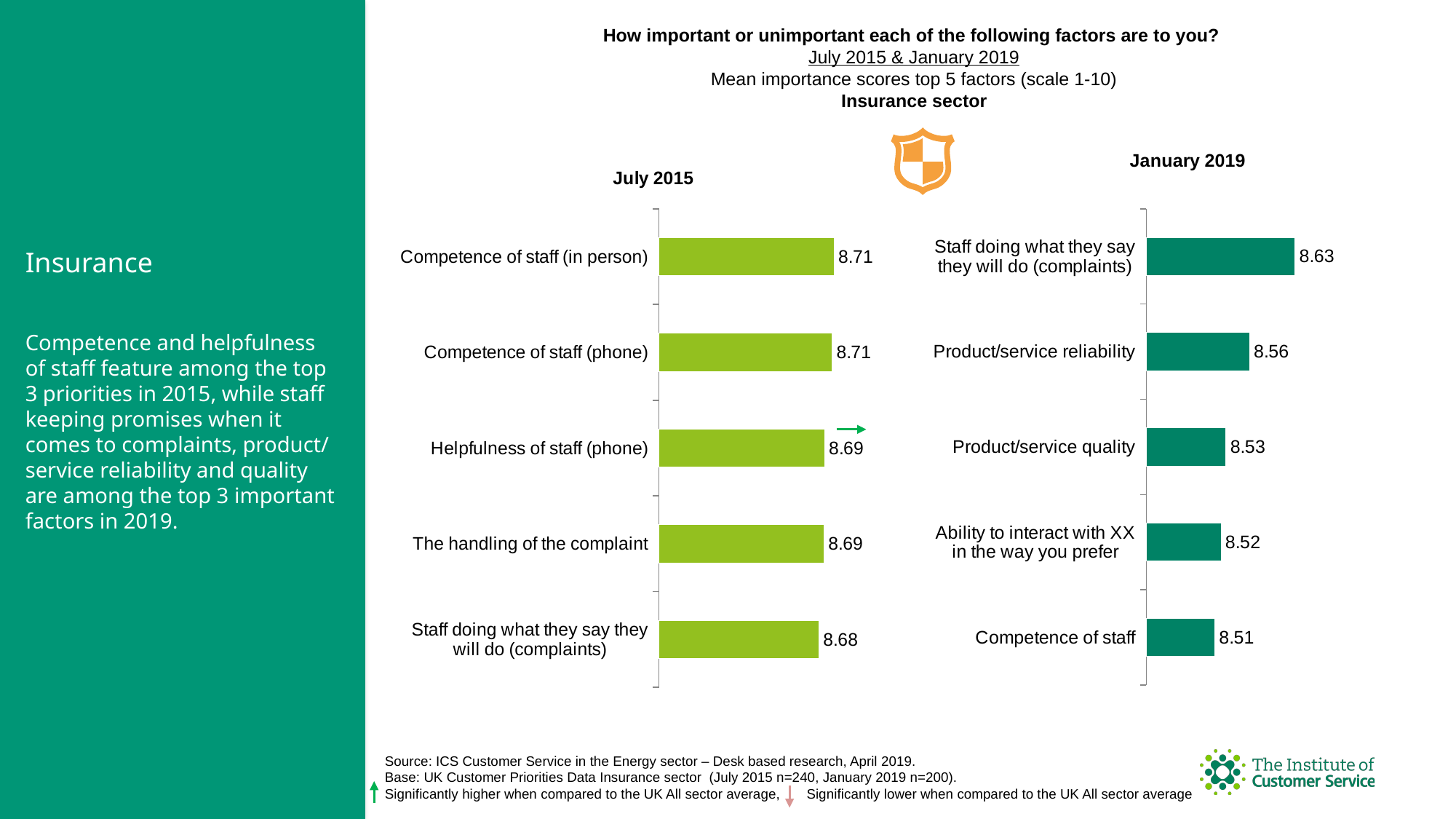
In the January 2019 chart, which factor has the highest mean importance score? Staff doing what they say they will do (complaints) In the July 2015 chart, what is the score for Staff doing what they say they will do (complaints)? 8.68 In the July 2015 chart, which factor has the lowest mean importance score? Staff doing what they say they will do (complaints) What is the difference between the July 2015 score for Competence of staff (in person) and the January 2019 score for Product/service quality? 0.18 In the July 2015 chart, what is the mean importance score for Helpfulness of staff (phone)? 8.69 How many factors are shown in the July 2015 chart? 5 What type of chart is used to show the January 2019 scores? Bar chart In the January 2019 chart, which factor has the lowest mean importance score? Competence of staff What is the difference between the January 2019 scores for Staff doing what they say they will do (complaints) and Competence of staff? 0.12 Which is larger: the January 2019 score for Product/service reliability or the January 2019 score for Ability to interact with XX in the way you prefer? Product/service reliability In the January 2019 chart, what is the score for Competence of staff? 8.51 In the January 2019 chart, what is the mean importance score for Product/service reliability? 8.56